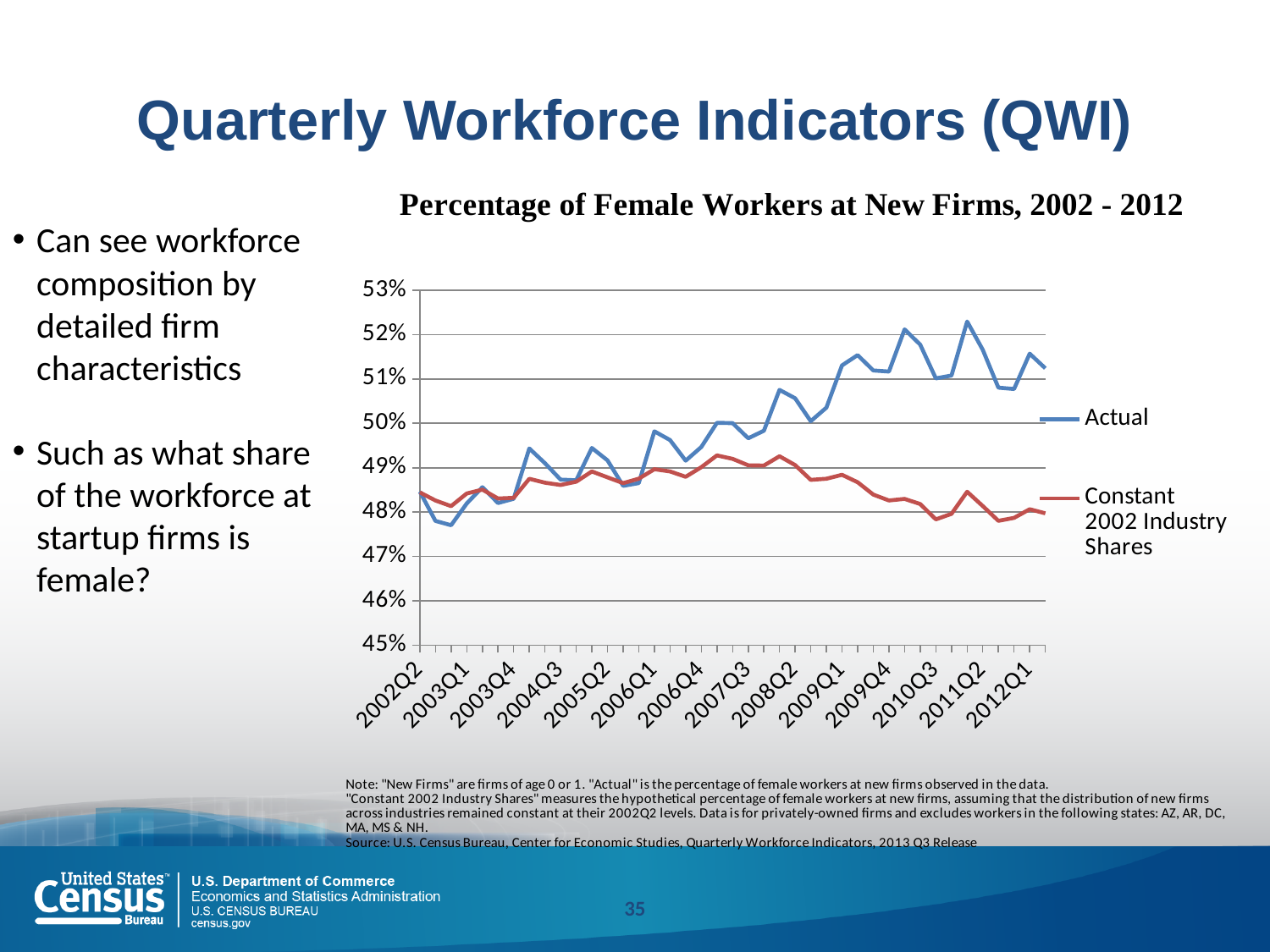
What kind of chart is shown on the slide? line chart At 2009Q4, which series is higher, Actual or Constant 2002 Industry Shares? Actual What is the title of the chart? Percentage of Female Workers at New Firms, 2002 - 2012 Is the Actual value at 2011Q2 greater or less than 51%? greater Does the Actual series generally rise or fall from 2002Q2 to 2012Q1? rise Is the Actual value at 2003Q1 greater or less than 49%? less Does the Constant 2002 Industry Shares series rise or fall between 2007Q3 and 2012Q1? fall What are the two series named in the chart's legend? Actual; Constant 2002 Industry Shares At 2012Q1, which series has the higher value, Actual or Constant 2002 Industry Shares? Actual Is the Constant 2002 Industry Shares value at 2012Q1 greater or less than 49%? less How many series does the chart's legend list? 2 What is the highest value labelled on the vertical axis? 53%